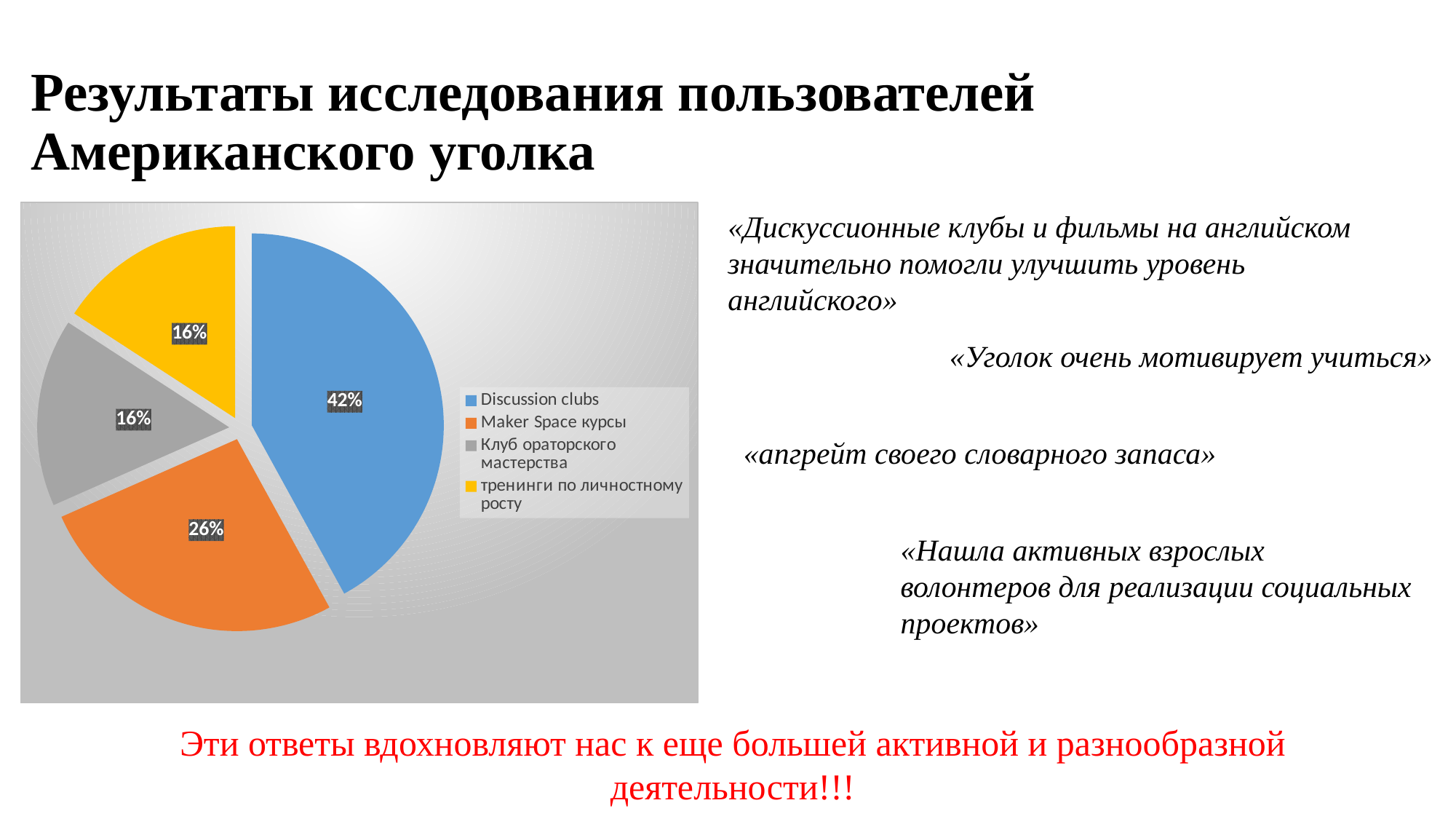
Which category has the largest slice of the pie? Discussion clubs How many slices does the pie chart have? 4 What share of the pie does Клуб ораторского мастерства have? 16% Which is larger, the share for Maker Space курсы or the share for Клуб ораторского мастерства? Maker Space курсы What is the difference between the shares of Discussion clubs and Maker Space курсы? 16% What share of the pie does тренинги по личностному росту have? 16% How many entries does the legend list? 4 What kind of chart is shown on the slide? pie chart What colour is the slice for тренинги по личностному росту? yellow What colour is the Discussion clubs slice? blue What share of the pie does Maker Space курсы have? 26%